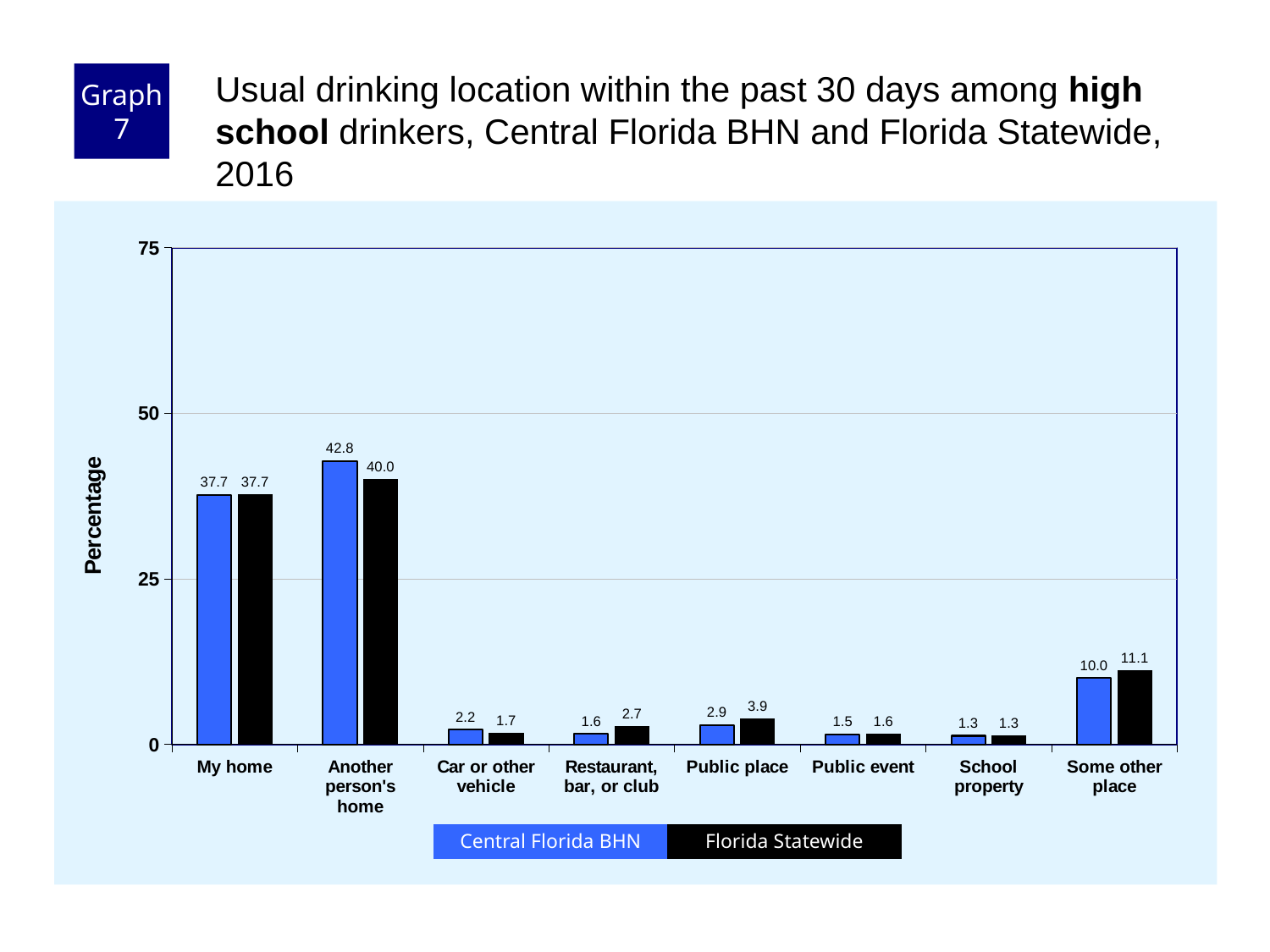
What is the Central Florida BHN value for Another person's home? 42.8 What is the Florida Statewide value for Public place? 3.9 Which category has the highest Central Florida BHN value? Another person's home How many location categories are shown on the x axis? 8 How many series does the legend list? 2 What is the difference between the Central Florida BHN and Florida Statewide values for Another person's home? 2.8 What kind of chart is shown on the slide? bar chart Which category has the lowest Florida Statewide value? School property Is the Florida Statewide value for My home greater or less than 25? greater What is the Florida Statewide value for Some other place? 11.1 What is the label on the y axis? Percentage Which is larger for Restaurant, bar, or club: Central Florida BHN or Florida Statewide? Florida Statewide